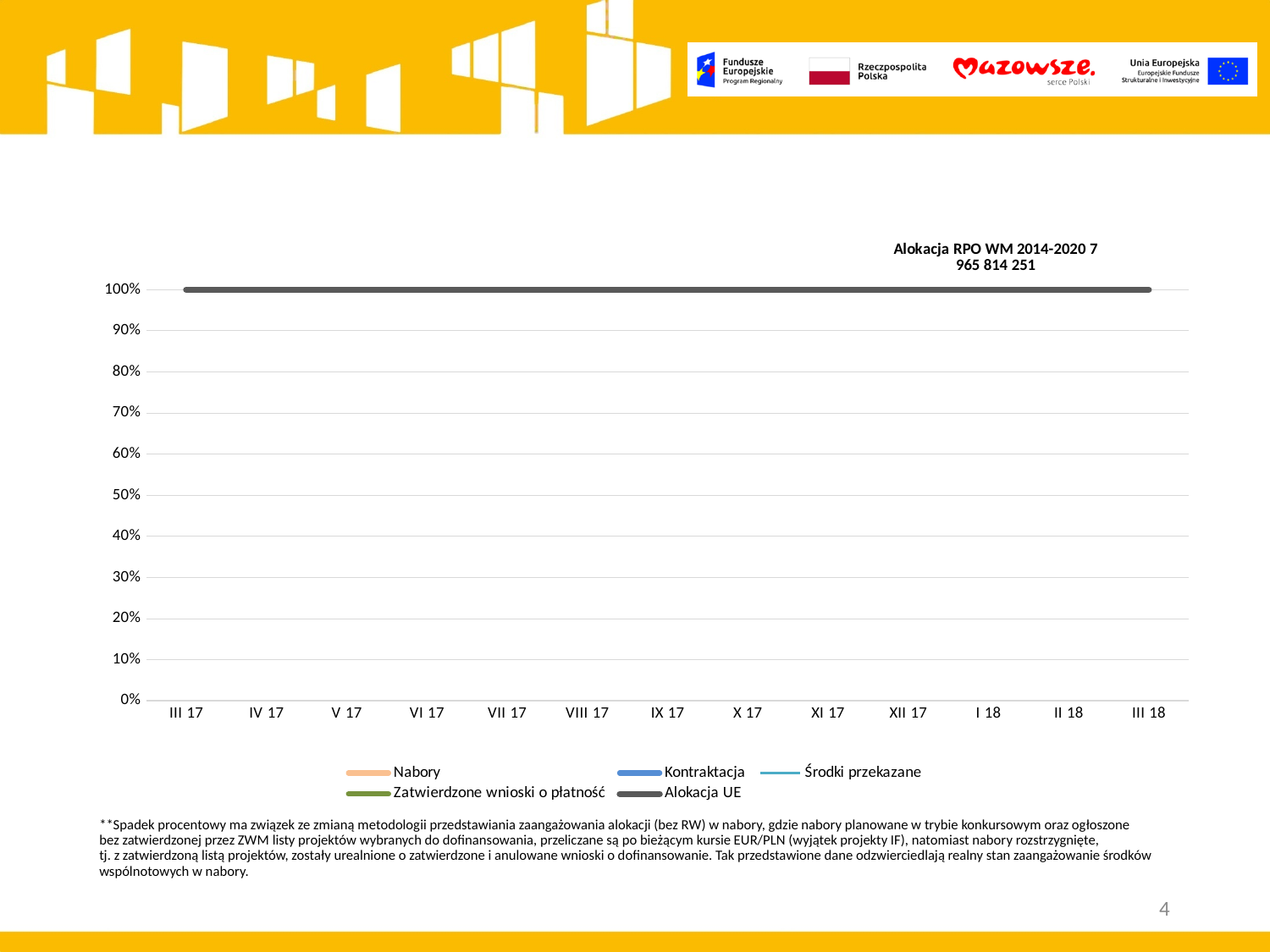
Does the Alokacja UE line rise, fall or stay flat from III 17 to III 18? stays flat What is the highest value shown on the chart's y axis? 100% How many series does the chart legend list? 5 What is the value of the Alokacja UE line in III 18? 100% What is the value of the Alokacja UE line in III 17? 100% What is the last period shown on the x axis of the chart? III 18 What is the first period shown on the x axis of the chart? III 17 Is the value of Alokacja UE in XII 17 greater or less than 90%? greater How many time periods are shown along the x axis of the chart? 13 What kind of chart is shown on the slide? line chart